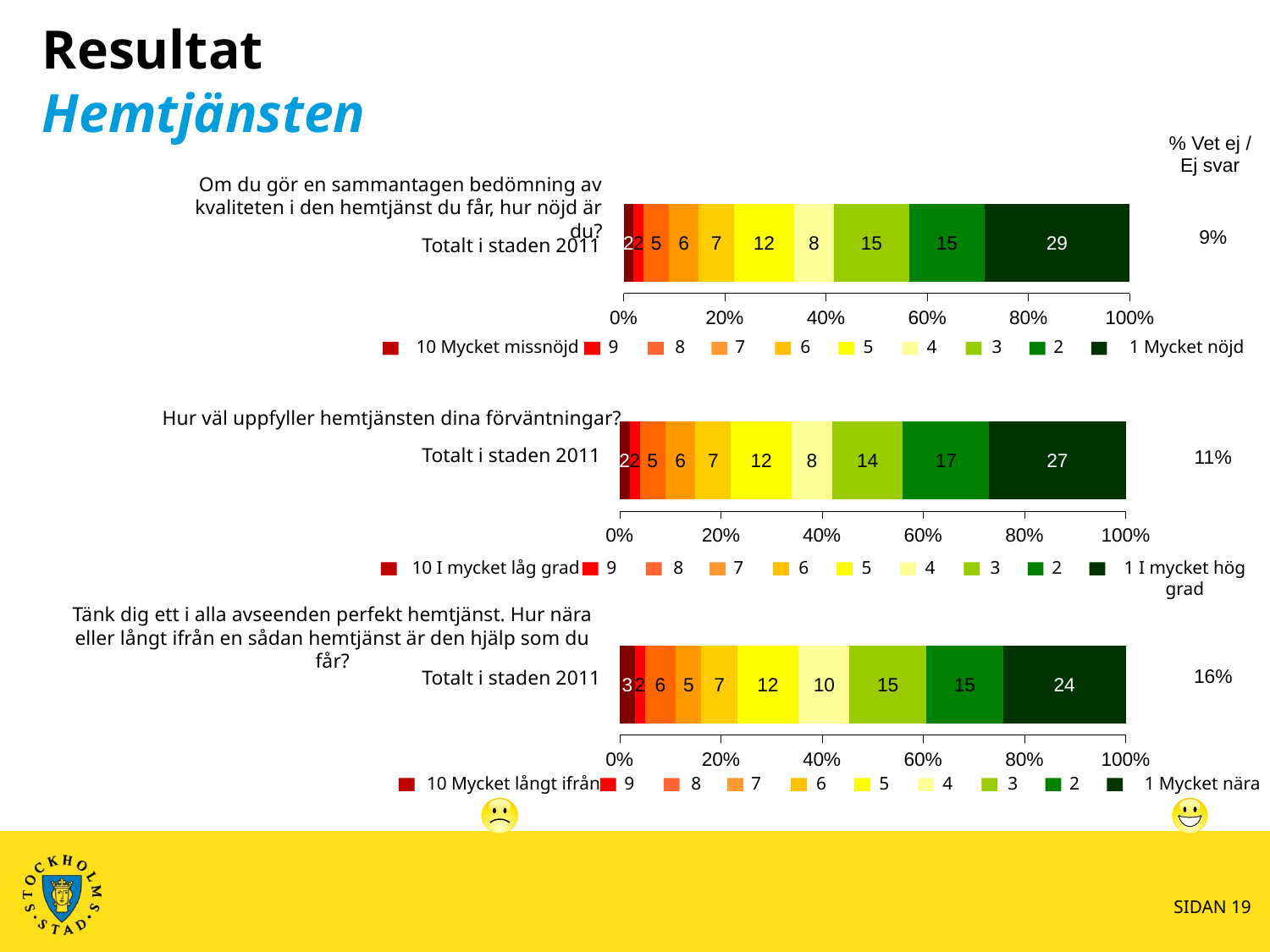
In the middle chart, what is the total of all segments in the "Totalt i staden 2011" bar? 100 In the top chart, which legend category has the largest segment? 1 Mycket nöjd How many series does the legend of the top chart list? 10 In the top chart ("Om du gör en sammantagen bedömning av kvaliteten i den hemtjänst du får, hur nöjd är du?"), what value is shown for the "1 Mycket nöjd" segment? 29 In the bottom chart, which legend category has the largest segment? 1 Mycket nära In the middle chart, which segment is larger: "2" or "3"? 2 In the middle chart ("Hur väl uppfyller hemtjänsten dina förväntningar?"), what value is shown for the "5" segment? 12 In the bottom chart, which segment is larger: "1 Mycket nära" or "3"? 1 Mycket nära In the top chart, what is the difference between the "1 Mycket nöjd" segment and the "2" segment? 14 What kind of chart is used for the middle chart? Stacked bar chart What is the "% Vet ej / Ej svar" value shown next to the bottom chart? 16% In the bottom chart ("Tänk dig ett i alla avseenden perfekt hemtjänst..."), what value is shown for the "4" segment? 10